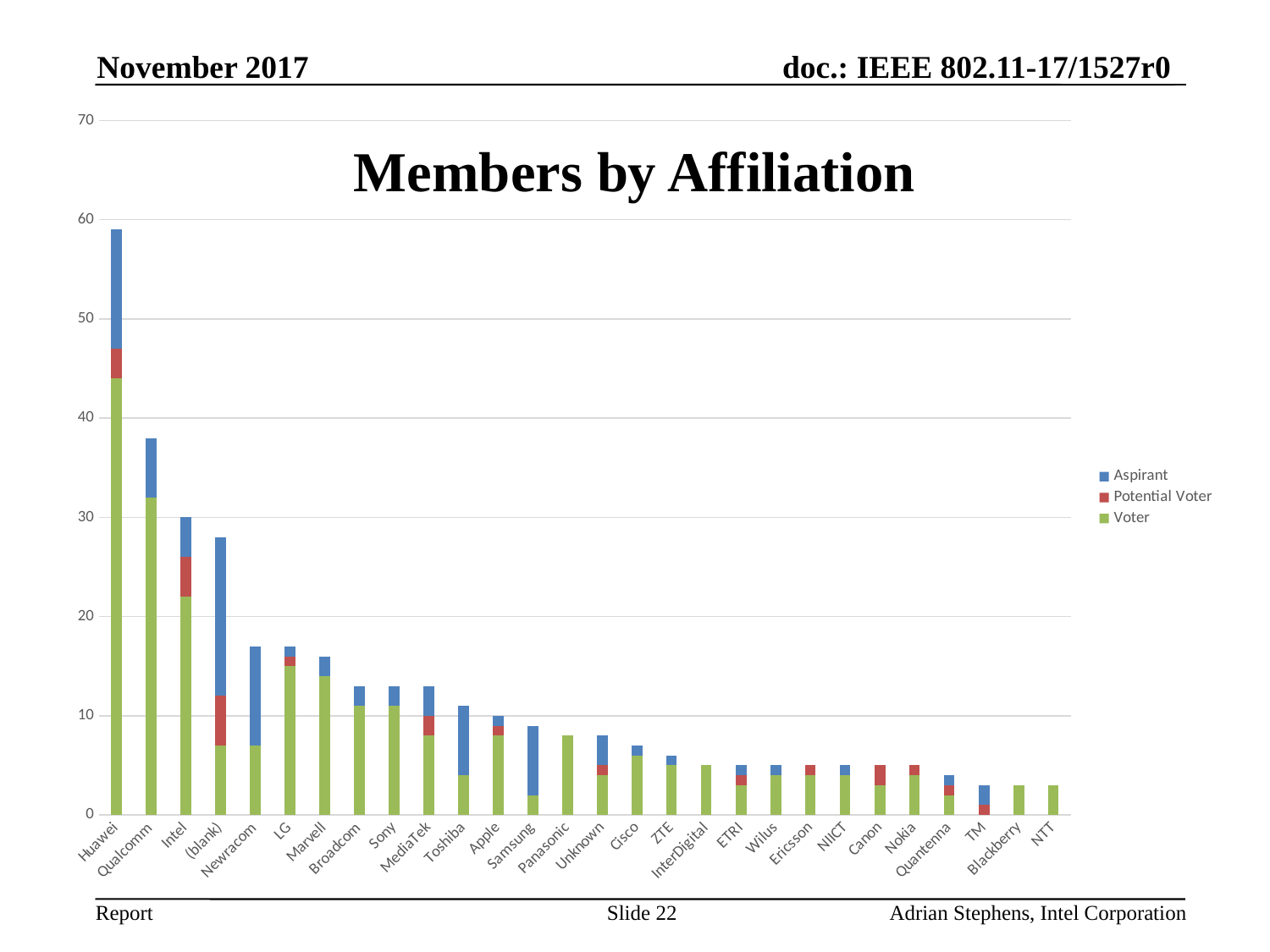
Which has a larger total, Qualcomm or Intel? Qualcomm Do the total bar heights generally rise or fall from left to right along the x axis? fall Is the total value for Panasonic greater or less than 10? less Is the total value for Qualcomm greater or less than 40? less Which series are listed in the legend? Aspirant, Potential Voter, Voter Is the total value for Newracom greater or less than 10? greater How many affiliations are shown on the x axis? 28 Which affiliation has the highest total number of members? Huawei How many series does the legend list? 3 What is the title of the chart? Members by Affiliation What kind of chart is shown on the slide? Stacked bar chart